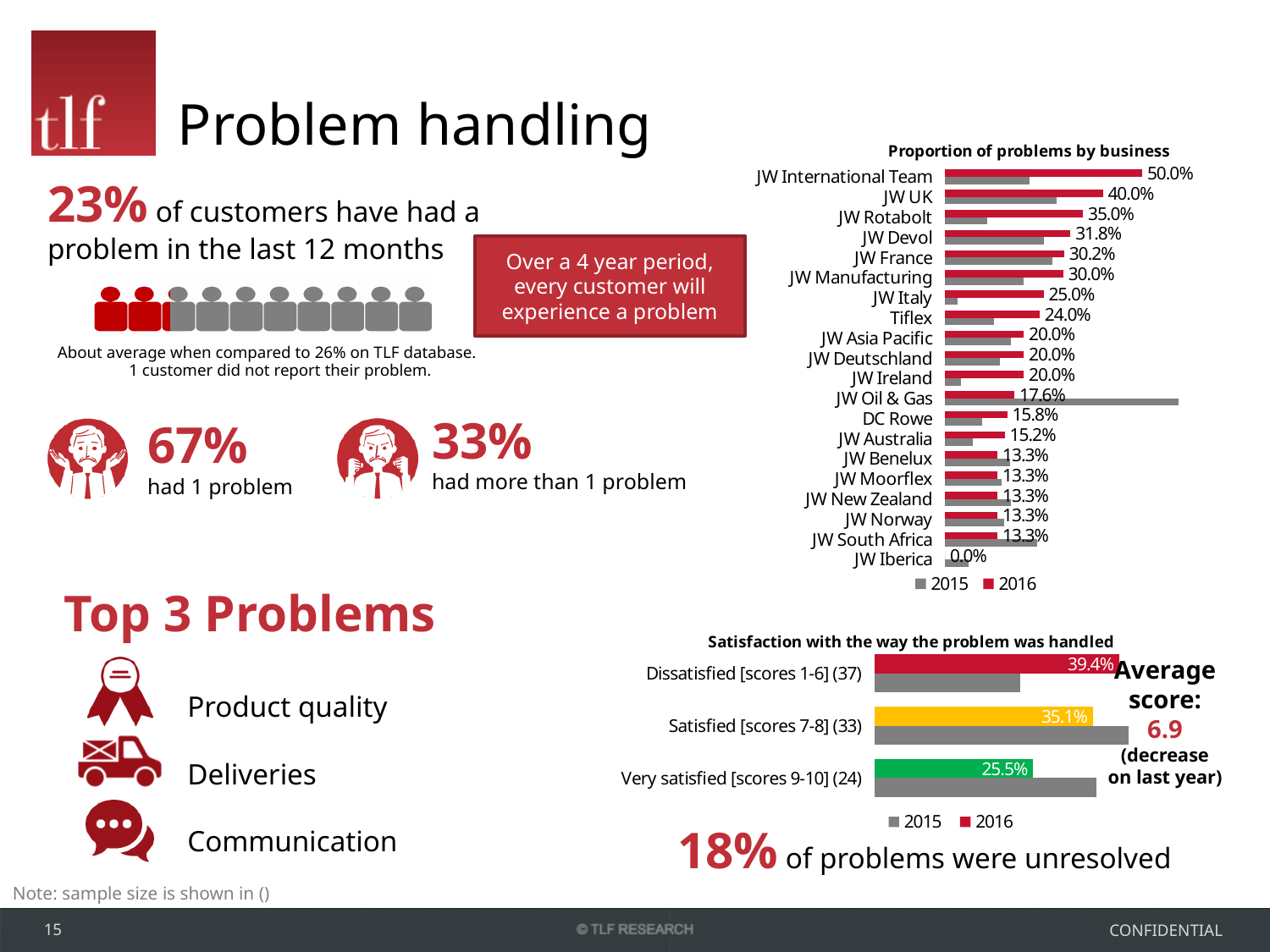
What kind of chart is 'Proportion of problems by business'? Bar chart In the 'Proportion of problems by business' chart, what is the 2016 value for JW UK? 40.0% In the 'Satisfaction with the way the problem was handled' chart, which category has the highest 2016 value? Dissatisfied [scores 1-6] What are the two legend entries in the 'Satisfaction with the way the problem was handled' chart? 2015 and 2016 How many businesses are listed in the 'Proportion of problems by business' chart? 20 In the 'Proportion of problems by business' chart, which business has the lowest 2016 value? JW Iberica How many series does the legend of the 'Proportion of problems by business' chart list? 2 In the 'Proportion of problems by business' chart, which business has the highest 2016 value? JW International Team In the 'Satisfaction with the way the problem was handled' chart, what is the 2016 value for Dissatisfied [scores 1-6]? 39.4% In the 'Proportion of problems by business' chart, what is the difference between the 2016 values for JW International Team and JW UK? 10.0% In the 'Satisfaction with the way the problem was handled' chart, what is the difference between the 2016 values for Dissatisfied [scores 1-6] and Very satisfied [scores 9-10]? 13.9% In the 'Proportion of problems by business' chart, which has the larger 2016 value, JW Devol or JW France? JW Devol